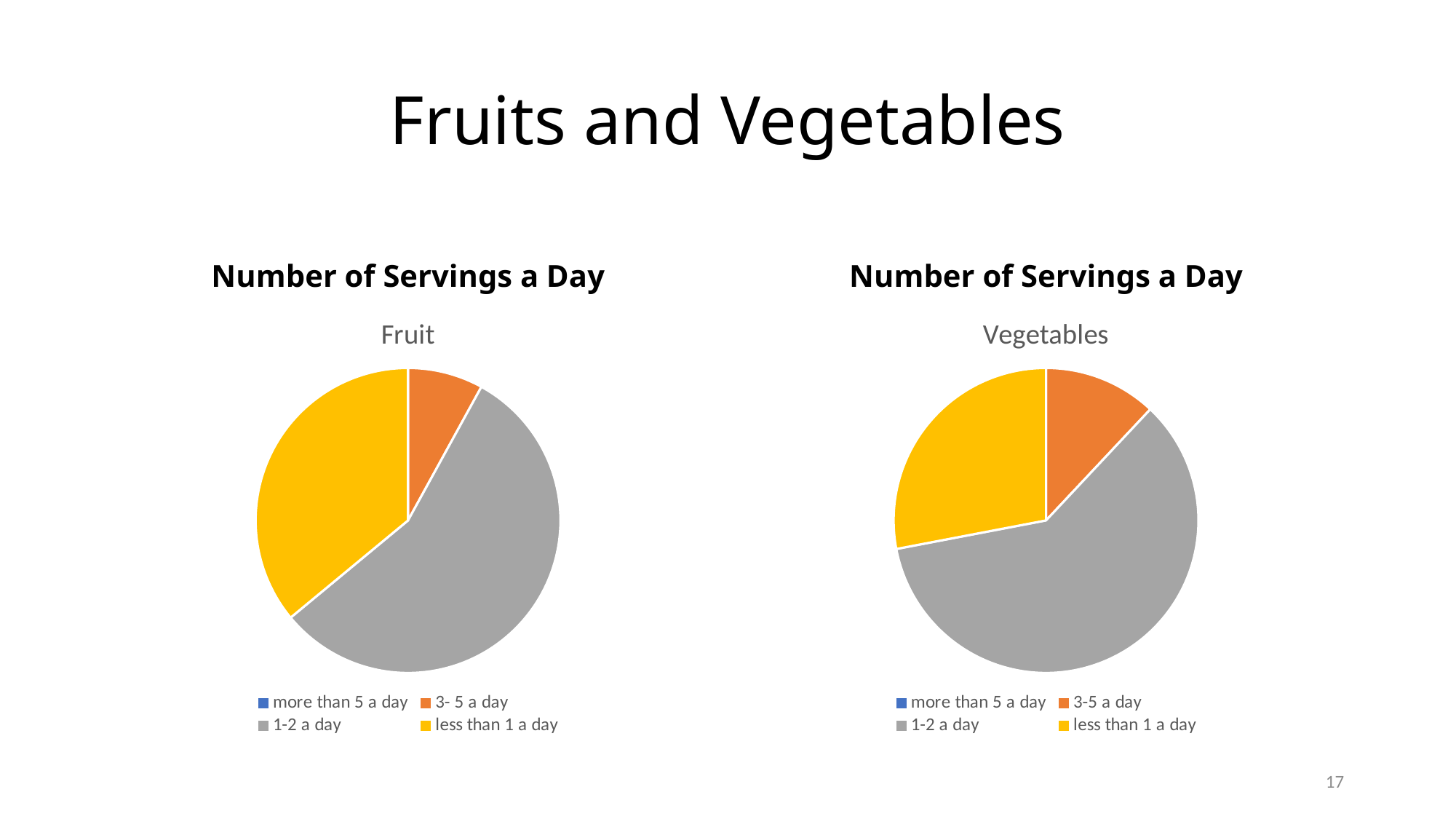
In the Vegetables pie chart, what colour represents the 1-2 a day category? gray What kind of chart is the Vegetables chart on the right? pie chart In the Vegetables pie chart, which slice is larger: less than 1 a day or 1-2 a day? 1-2 a day What kind of chart is the Fruit chart on the left? pie chart In the Fruit pie chart, which slice is larger: 3- 5 a day or less than 1 a day? less than 1 a day What is the title shown above the Fruit pie chart? Number of Servings a Day In the Vegetables pie chart, which category has the largest slice? 1-2 a day In the Vegetables pie chart, which slice is larger: 3-5 a day or 1-2 a day? 1-2 a day How many categories does the legend of the Fruit pie chart list? 4 How many categories does the legend of the Vegetables pie chart list? 4 In the Fruit pie chart, which category has the largest slice? 1-2 a day